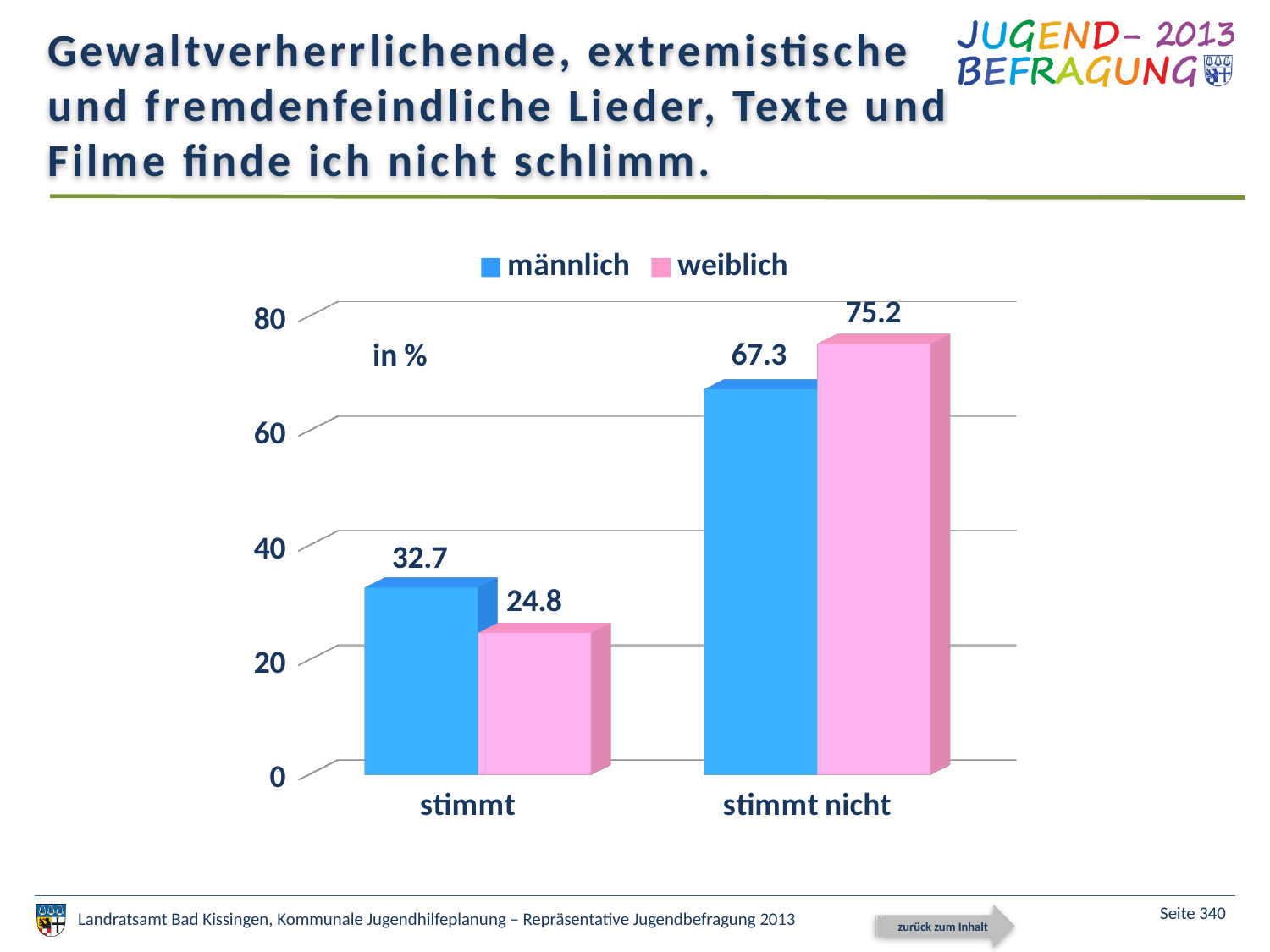
What is the value for weiblich in the stimmt nicht category? 75.2 What is the value for männlich in the stimmt nicht category? 67.3 What is the difference between the weiblich and männlich values in the stimmt nicht category? 7.9 What is the value for männlich in the stimmt category? 32.7 What is the difference between the männlich and weiblich values in the stimmt category? 7.9 How many series does the legend list? 2 Which bar has the highest value in the chart? weiblich, stimmt nicht In the stimmt category, which is larger: männlich or weiblich? männlich What kind of chart is shown on the slide? bar chart What is the value for weiblich in the stimmt category? 24.8 How many categories are shown on the x axis? 2 Which bar has the lowest value in the chart? weiblich, stimmt